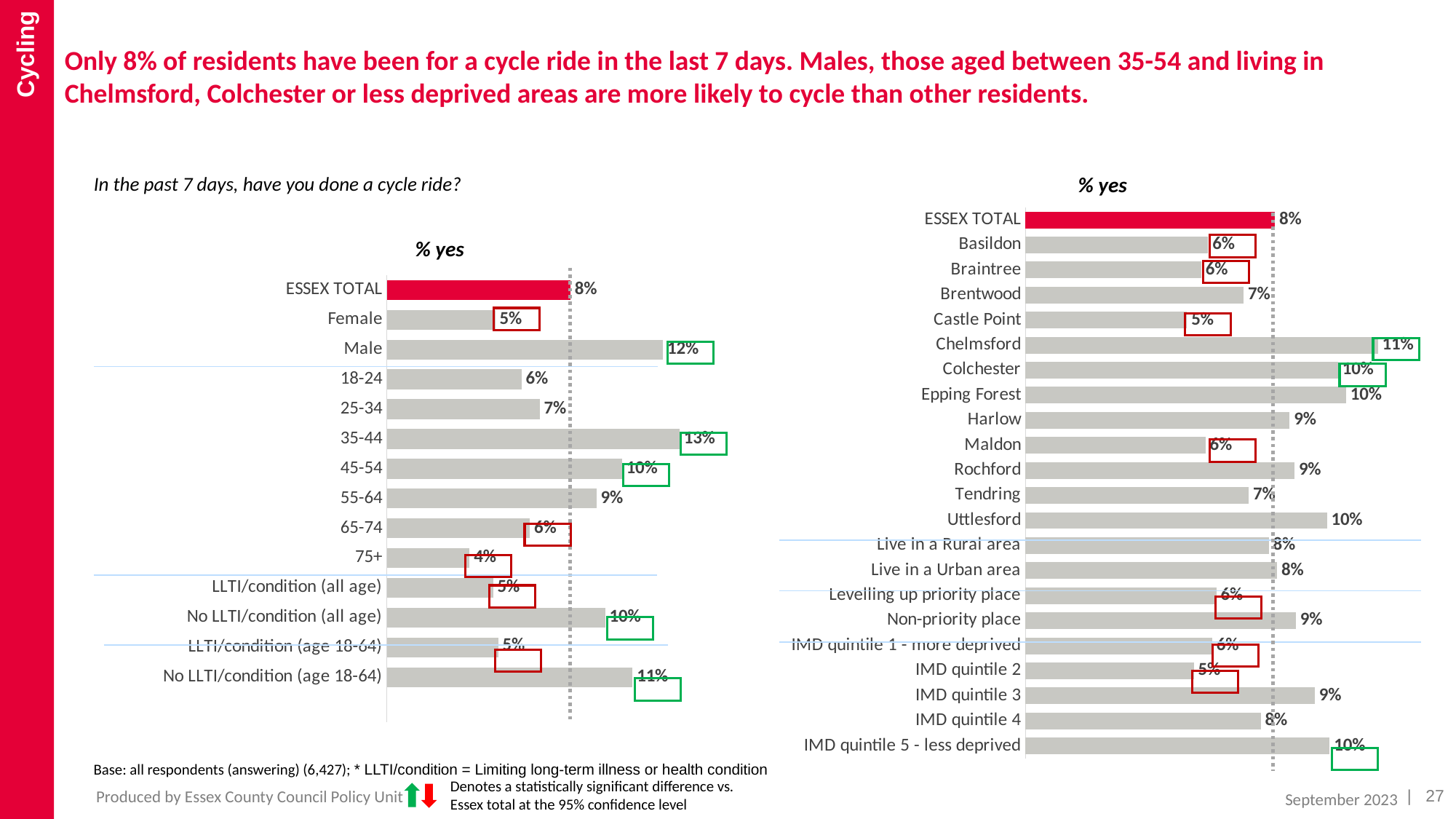
On the right chart, what is the % yes value for Chelmsford? 11% On the right chart, what is the difference between the values for IMD quintile 5 - less deprived and IMD quintile 2? 5% On the right chart, what is the % yes value for Live in a Urban area? 8% What type of chart is used on the left side of the slide? Bar chart On the left chart, which is larger: the value for 45-54 or the value for 55-64? 45-54 On the right chart, which district has the lowest % yes value? Castle Point On the left chart, what is the difference between the Male and Female % yes values? 7% On the left chart, what is the % yes value for Male? 12% On the left chart, which category has the highest % yes value? 35-44 On the left chart, what is the % yes value for the 75+ age group? 4% On the left chart, what is the % yes value for ESSEX TOTAL? 8% On the right chart, which is larger: the value for Harlow or the value for Tendring? Harlow